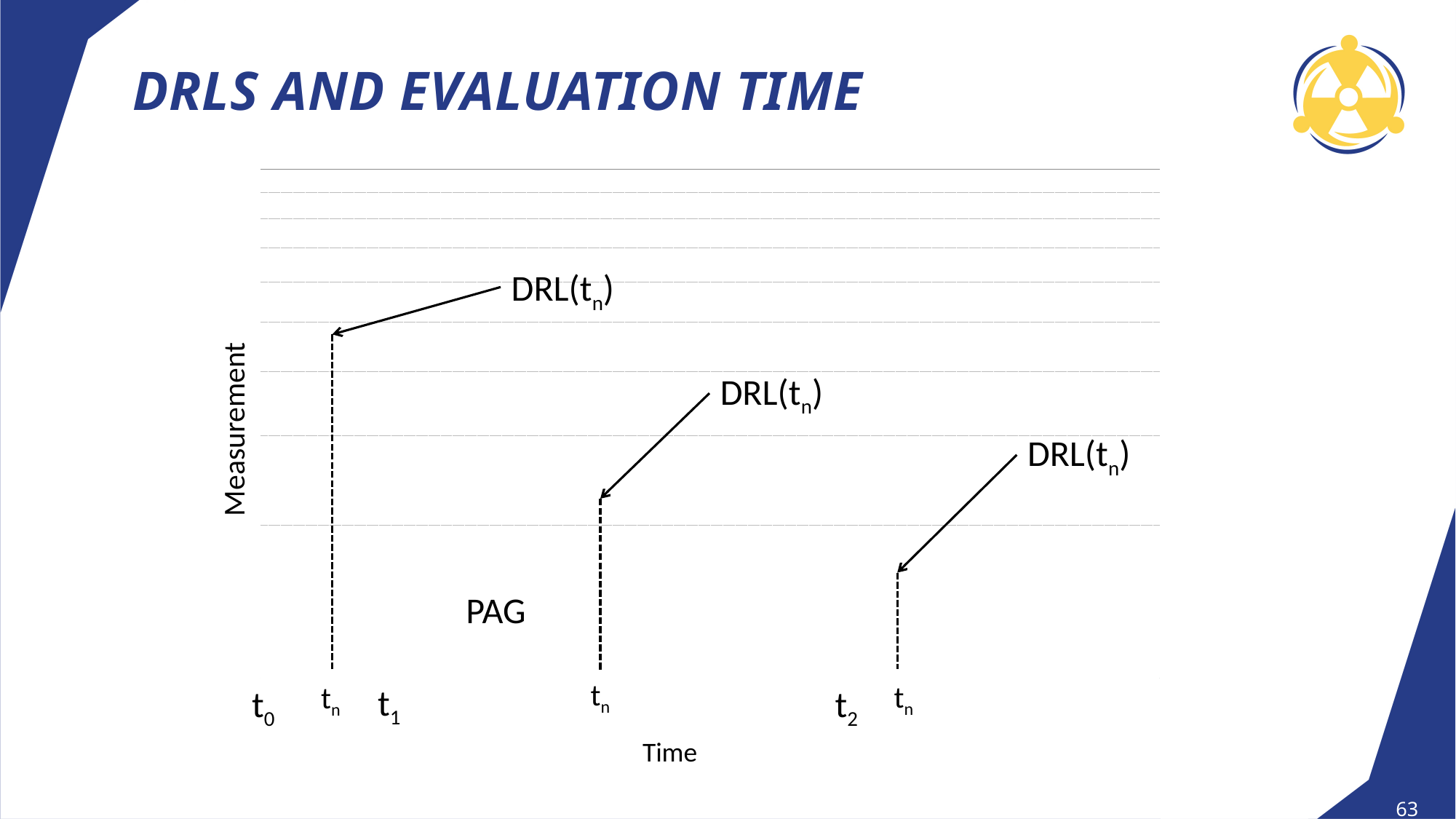
Which DRL(tn) marker is the lowest: the one after t0, the one after t1, or the one after t2? the one after t2 Is the DRL(tn) level after t0 higher or lower than the DRL(tn) level after t2? higher What text label appears between the first and second dashed lines, below the DRL markers? PAG Is the DRL(tn) level after t1 higher or lower than the DRL(tn) level after t0? lower What is the label on the horizontal axis of the chart? Time How many time points labelled t0, t1 and t2 are marked on the x axis? 3 What is the label on the vertical axis of the chart? Measurement Do the DRL(tn) levels rise or fall as time increases along the x axis? fall Which DRL(tn) marker is the highest: the one after t0, the one after t1, or the one after t2? the one after t0 How many DRL(tn) markers are shown on the chart? 3